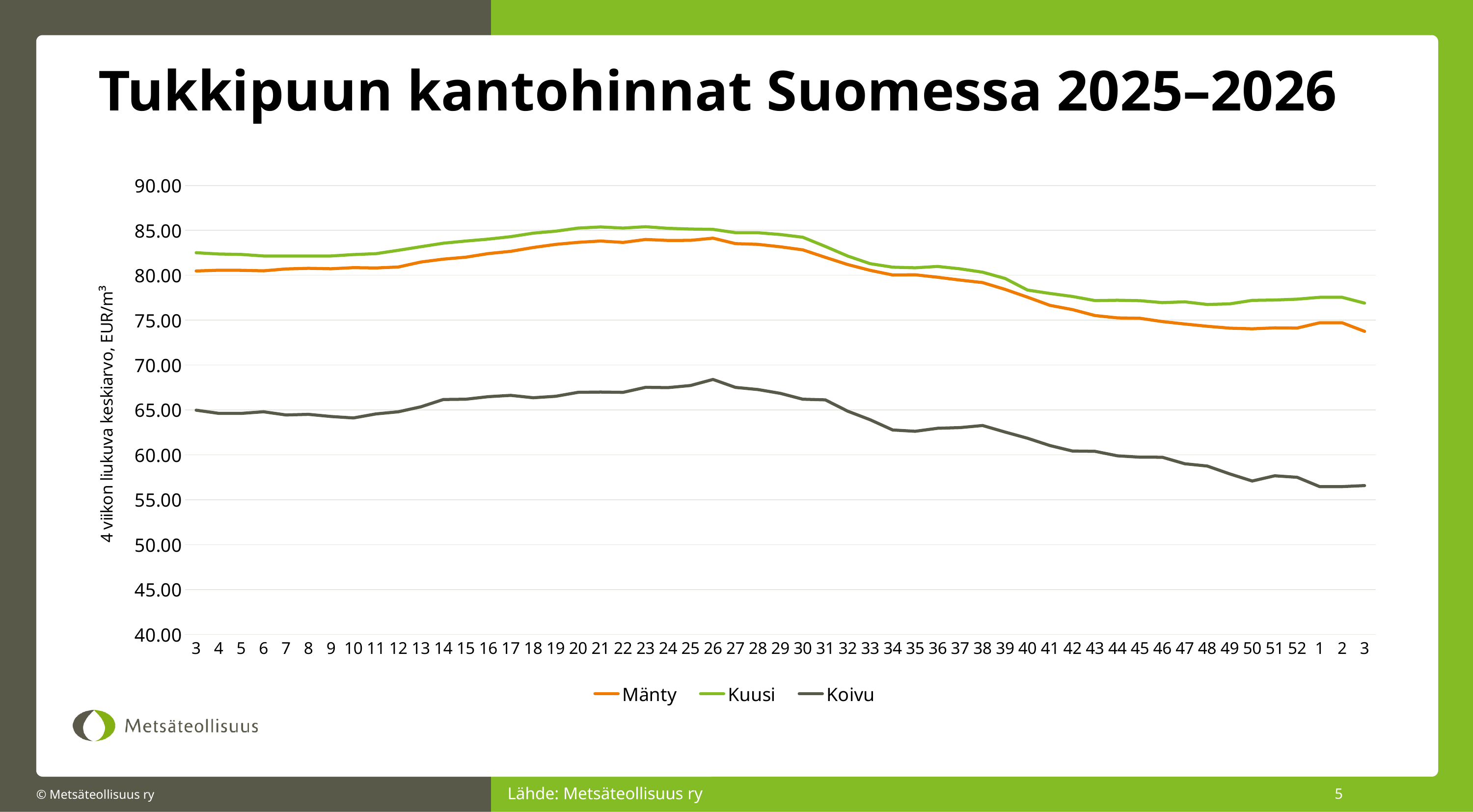
What kind of chart is shown on the slide? line chart Which series is plotted lowest across the whole chart? Koivu Which series is plotted highest across the whole chart? Kuusi Is the value for Mänty at week 50 greater or less than 80.00? less Is the value for Koivu at week 26 greater or less than 65.00? greater Is the value for Koivu at week 1 greater or less than 60.00? less What is the label of the y axis? 4 viikon liukuva keskiarvo, EUR/m³ How many series does the legend list? 3 Does the Kuusi line rise or fall from week 12 to week 21? rise Does the Koivu line rise or fall from week 38 to week 1? fall At week 20, which is larger, Kuusi or Koivu? Kuusi